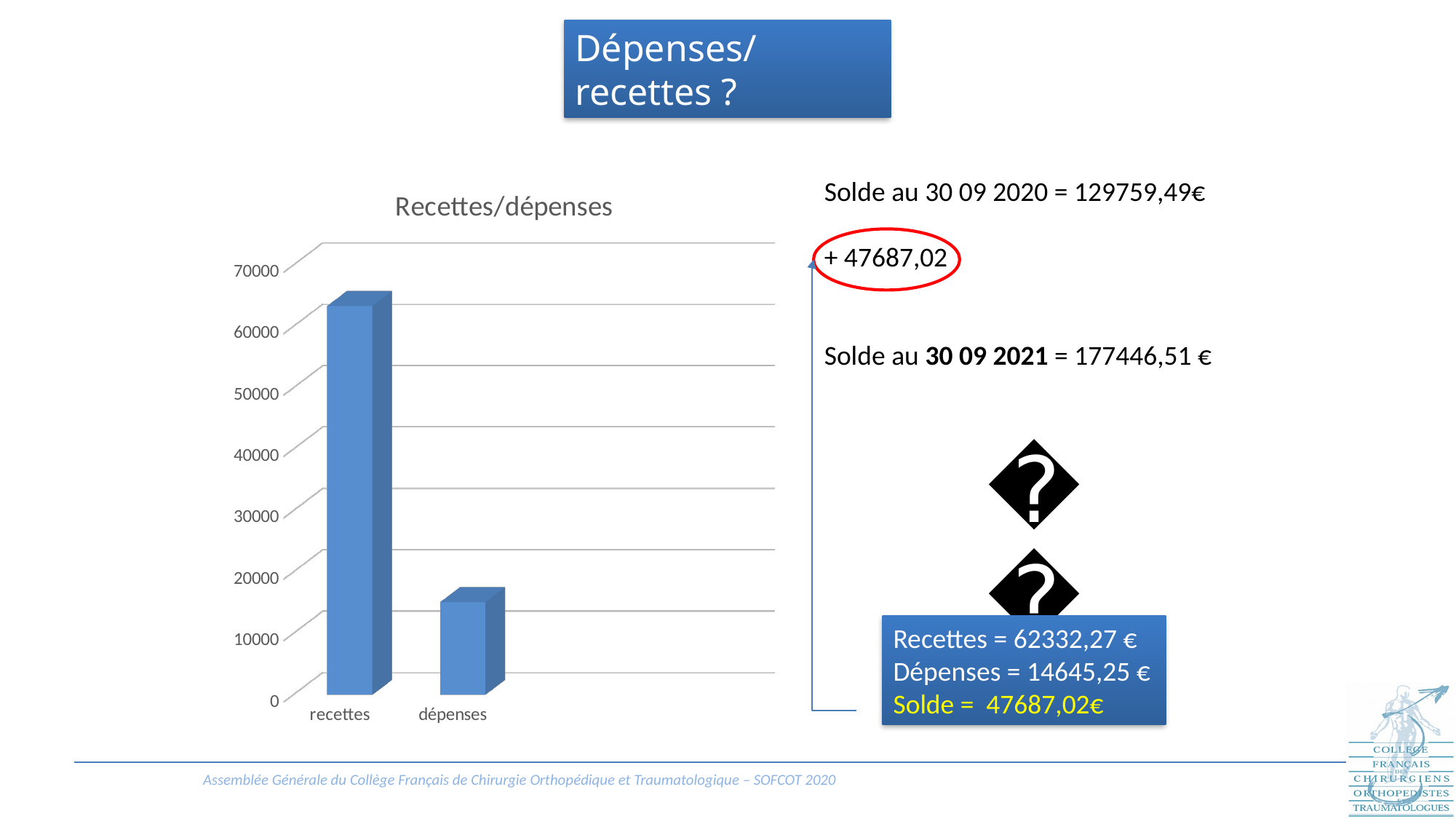
In the "Recettes/dépenses" chart, is the bar for recettes greater or less than 60000? greater How many categories are plotted in the "Recettes/dépenses" chart? 2 What type of chart is shown under the title "Recettes/dépenses"? bar chart Which category has the lowest bar in the "Recettes/dépenses" chart? dépenses In the "Recettes/dépenses" chart, is the bar for dépenses greater or less than 20000? less What is the highest value shown on the vertical axis of the "Recettes/dépenses" chart? 70000 Which category has the highest bar in the "Recettes/dépenses" chart? recettes What is the difference between recettes and dépenses as stated on the slide (Solde)? 47687,02€ In the "Recettes/dépenses" chart, is the bar for dépenses greater or less than 10000? greater Which is larger in the "Recettes/dépenses" chart, recettes or dépenses? recettes